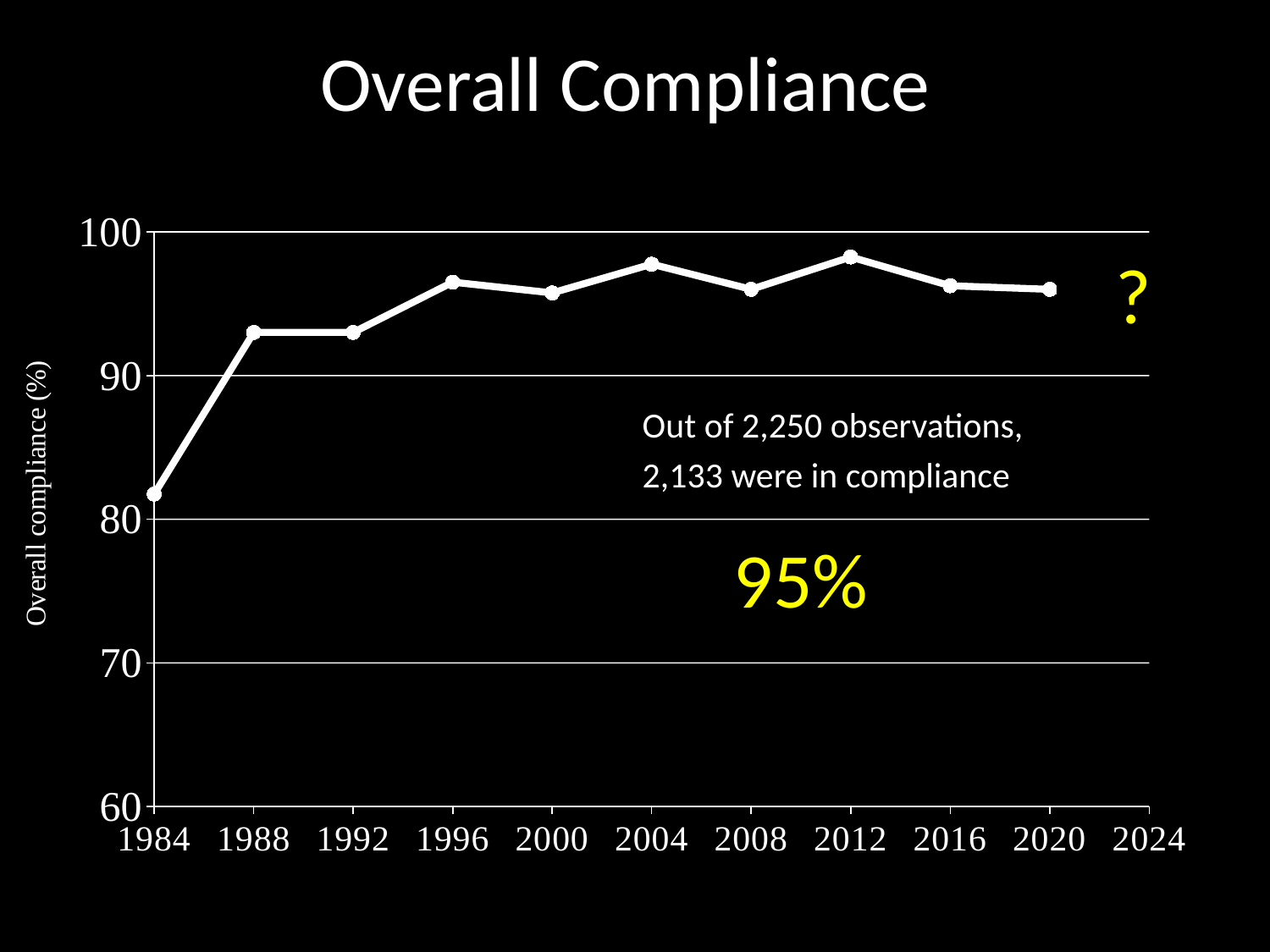
What is the label on the y axis? Overall compliance (%) Is the value for 1988 greater or less than 90? greater Is the value for 1984 greater or less than 80? greater Which year has the larger overall compliance value, 1984 or 1988? 1988 Does overall compliance rise or fall from 1984 to 1996? rise What is the title of the chart? Overall Compliance Is the value for 1984 greater or less than 90? less Which year has the highest overall compliance value? 2012 How many data points are plotted on the line? 10 Which year has the lowest overall compliance value? 1984 What kind of chart is shown on the slide? line chart